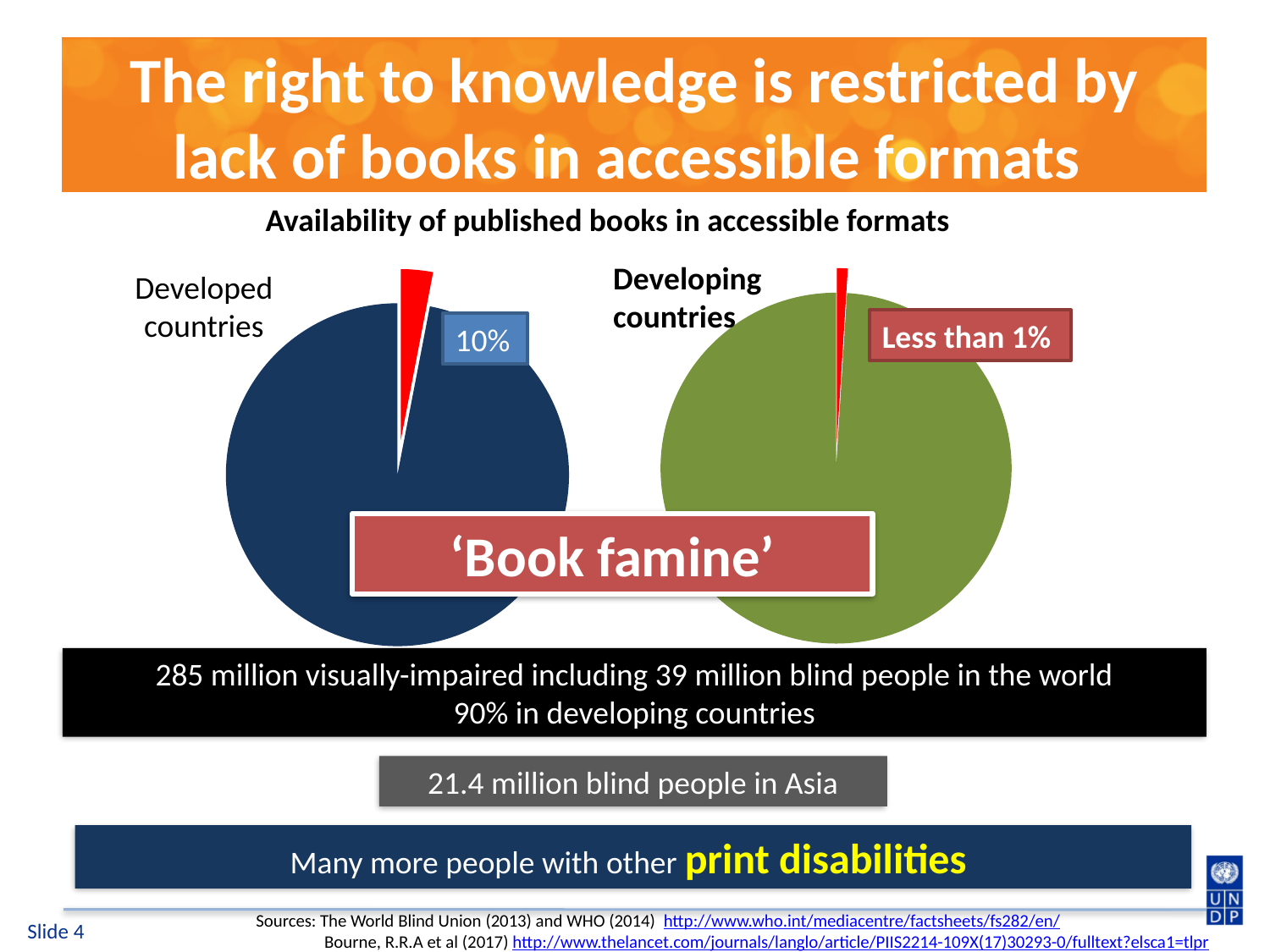
How many pie charts are shown on the slide? 2 How many slices does the Developed countries pie chart have? 2 Is the accessible-format share in the Developed countries pie chart greater or less than 50%? less Which pie chart shows the larger share of books available in accessible formats, Developed countries or Developing countries? Developed countries In the Developing countries pie chart, what label is given to the small red slice? Less than 1% What is the title shown above the two pie charts? Availability of published books in accessible formats In the Developed countries pie chart, what share of published books is shown as available in accessible formats? 10% Which pie chart shows the smaller share of books available in accessible formats, Developed countries or Developing countries? Developing countries What colour is the large slice in the Developing countries pie chart? green What kind of chart is used to show the availability of published books in accessible formats for developed countries? pie chart